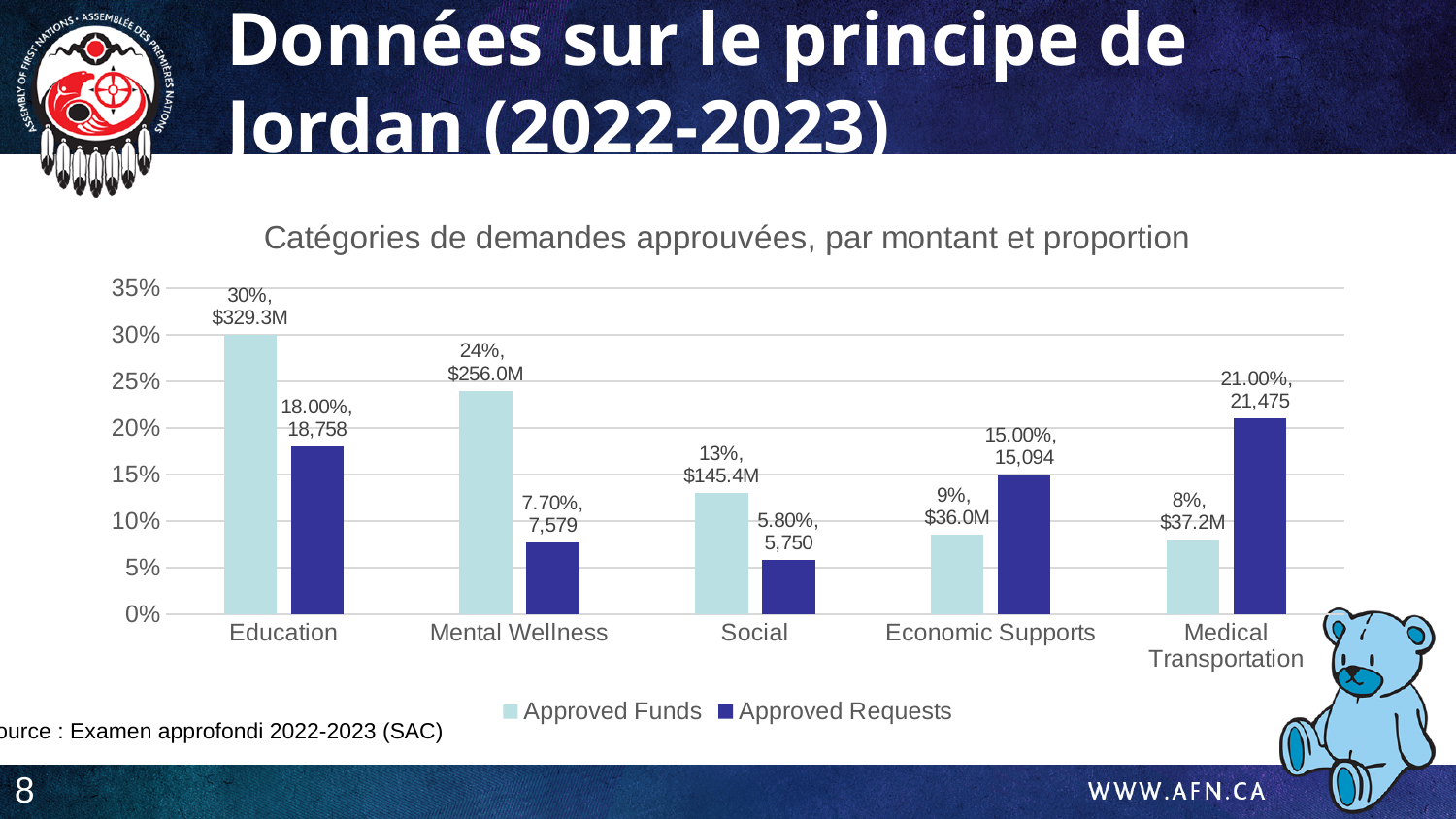
Which is larger in the Economic Supports category, the Approved Funds percentage or the Approved Requests percentage? Approved Requests What is the data label for Approved Requests in the Mental Wellness category? 7.70%, 7,579 What is the data label for Approved Funds in the Education category? 30%, $329.3M What is the difference between the Approved Requests percentage for Education and for Mental Wellness? 10.30% Which category has the highest Approved Funds percentage? Education What is the data label for Approved Requests in the Medical Transportation category? 21.00%, 21,475 How many series does the legend list? 2 What is the data label for Approved Funds in the Social category? 13%, $145.4M What is the title of the chart? Catégories de demandes approuvées, par montant et proportion What kind of chart is shown on the slide? bar chart Which category has the lowest Approved Requests percentage? Social How many categories are shown on the x axis? 5